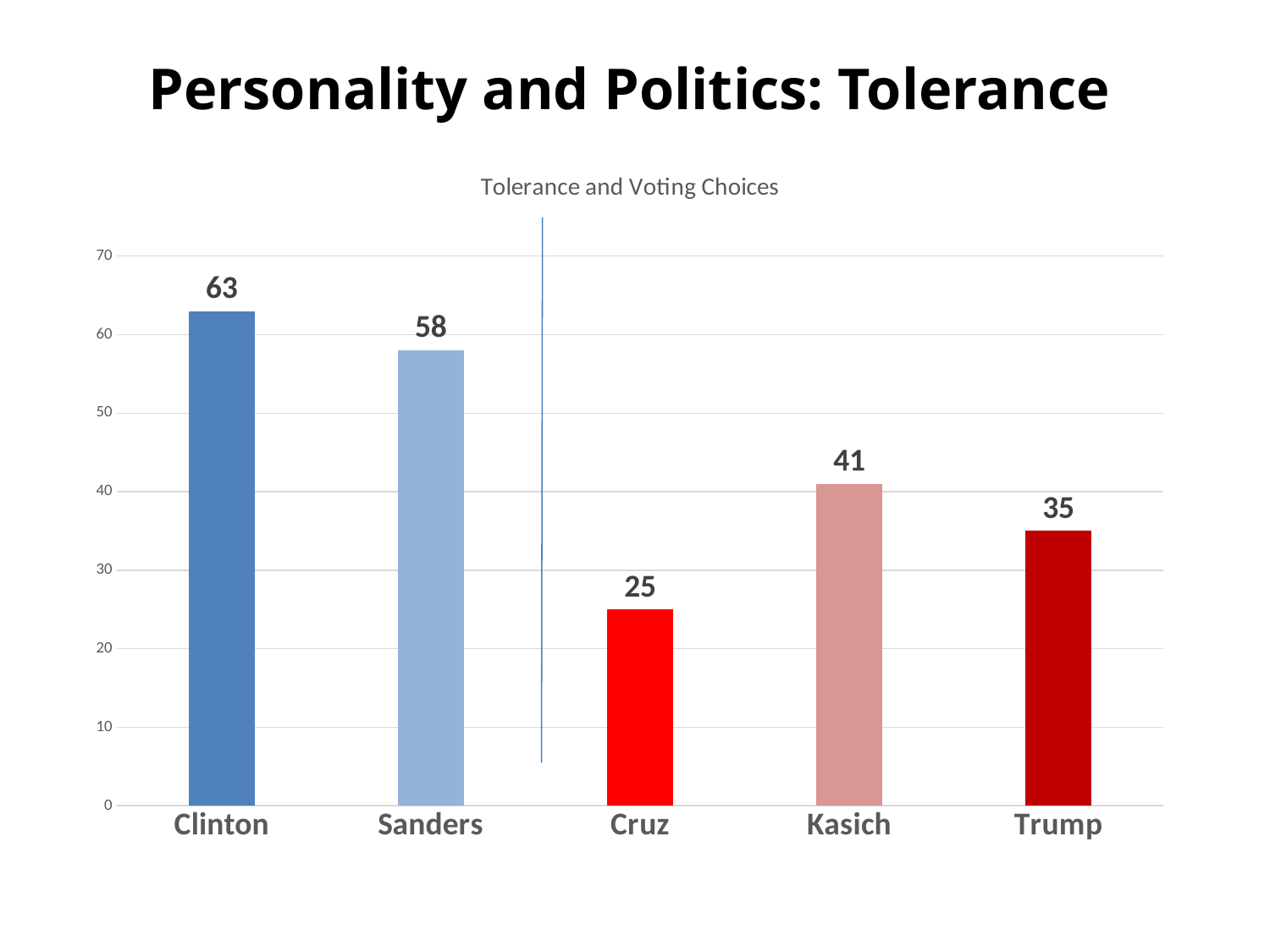
What is the difference between the values for Clinton and Sanders? 5 What is the difference between the values for Kasich and Trump? 6 Which candidate has the lowest value? Cruz Which candidate has the highest value? Clinton What is the value for Kasich? 41 What is the title of the chart? Tolerance and Voting Choices Which is larger, the value for Sanders or the value for Kasich? Sanders What is the value for Cruz? 25 Is the value for Trump greater or less than 40? less How many candidates are shown on the chart? 5 What kind of chart is shown on the slide? bar chart What is the value for Clinton? 63